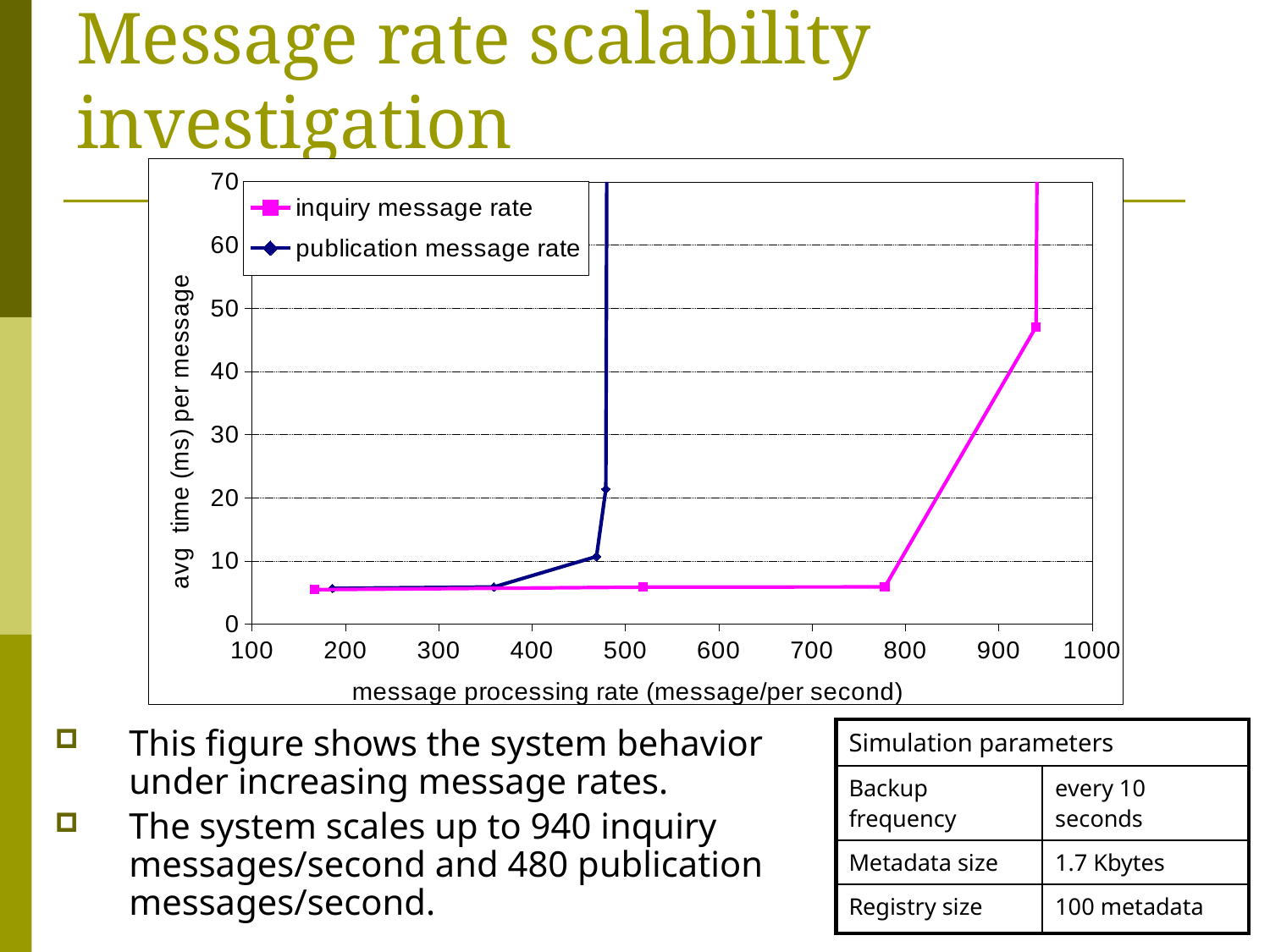
What is the label of the x axis of the chart? message processing rate (message/per second) Does the avg time per message for the publication message rate series rise or fall as the message processing rate increases along the x axis? rise Is the avg time per message for the inquiry message rate series at its last marked point (around 940 messages/second) greater or less than 40? greater Which series shoots up steeply at a higher message processing rate, inquiry message rate or publication message rate? inquiry message rate Does the avg time per message for the inquiry message rate series rise or fall as the message processing rate increases along the x axis? rise Is the avg time per message for the publication message rate series at about 480 messages/second greater or less than 10? greater What are the two series named in the chart legend? inquiry message rate, publication message rate What kind of chart is shown on the slide? line chart Is the avg time per message for the inquiry message rate series at about 780 messages/second greater or less than 10? less What is the highest value shown on the y axis of the chart? 70 How many series does the chart legend list? 2